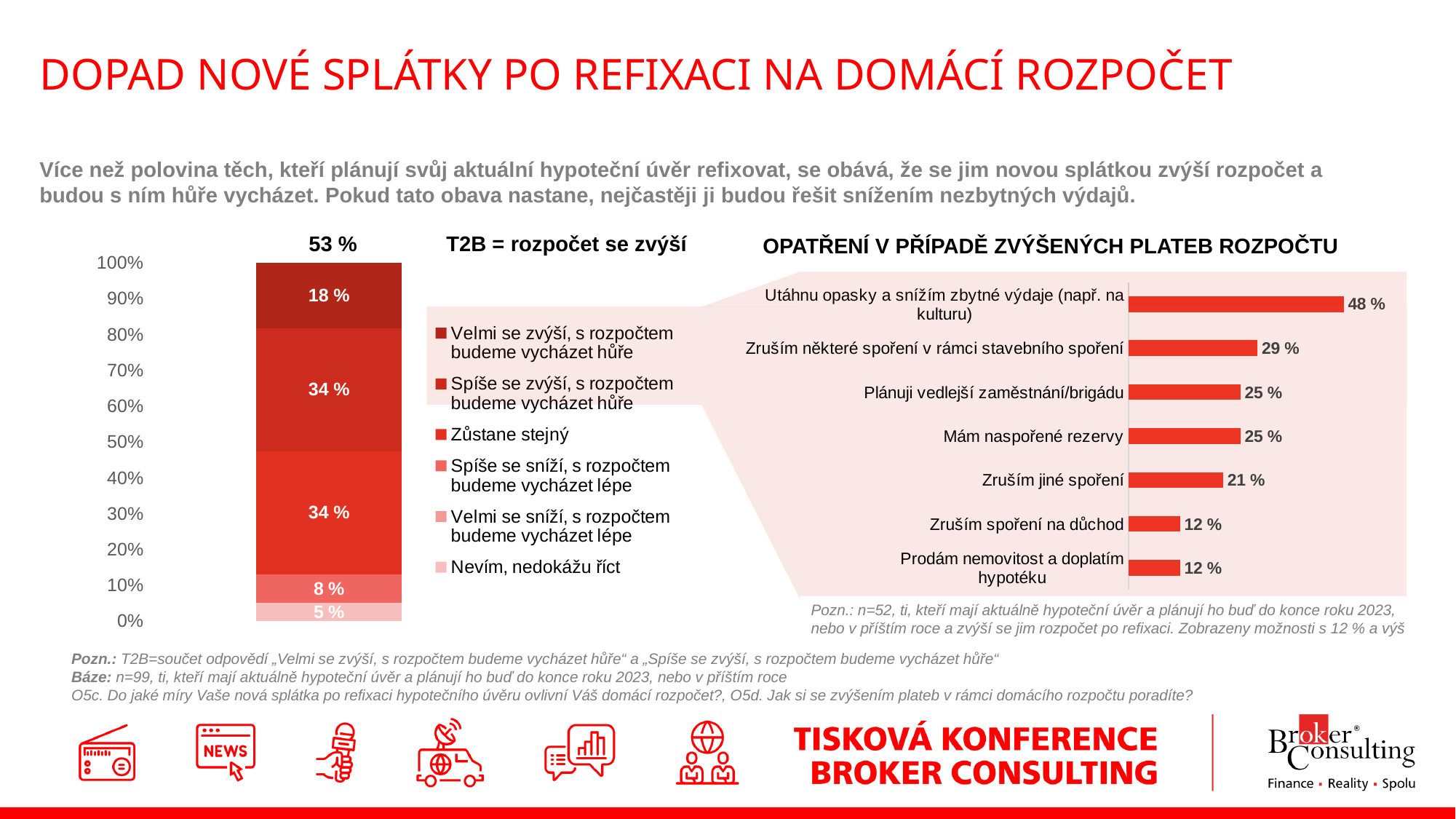
In the stacked bar chart on the left, what is the value of the 'Velmi se sníží, s rozpočtem budeme vycházet lépe' segment? 5 % In the stacked bar chart on the left, what is the value of the 'Spíše se sníží, s rozpočtem budeme vycházet lépe' segment? 8 % What kind of chart is the one titled 'OPATŘENÍ V PŘÍPADĚ ZVÝŠENÝCH PLATEB ROZPOČTU'? bar chart In the chart titled 'OPATŘENÍ V PŘÍPADĚ ZVÝŠENÝCH PLATEB ROZPOČTU', what is the value for 'Zruším některé spoření v rámci stavebního spoření'? 29 % What T2B value is printed above the stacked bar chart on the left? 53 % How many entries does the legend of the stacked bar chart on the left list? 6 In the chart titled 'OPATŘENÍ V PŘÍPADĚ ZVÝŠENÝCH PLATEB ROZPOČTU', which is larger: 'Plánuji vedlejší zaměstnání/brigádu' or 'Zruším spoření na důchod'? Plánuji vedlejší zaměstnání/brigádu In the chart titled 'OPATŘENÍ V PŘÍPADĚ ZVÝŠENÝCH PLATEB ROZPOČTU', what is the difference between 'Utáhnu opasky a snížím zbytné výdaje (např. na kulturu)' and 'Zruším některé spoření v rámci stavebního spoření'? 19 % In the chart titled 'OPATŘENÍ V PŘÍPADĚ ZVÝŠENÝCH PLATEB ROZPOČTU', how many categories are shown? 7 In the chart titled 'OPATŘENÍ V PŘÍPADĚ ZVÝŠENÝCH PLATEB ROZPOČTU', which category has the highest value? Utáhnu opasky a snížím zbytné výdaje (např. na kulturu) In the chart titled 'OPATŘENÍ V PŘÍPADĚ ZVÝŠENÝCH PLATEB ROZPOČTU', what is the value for 'Zruším jiné spoření'? 21 % In the stacked bar chart on the left, what is the value of the 'Velmi se zvýší, s rozpočtem budeme vycházet hůře' segment? 18 %